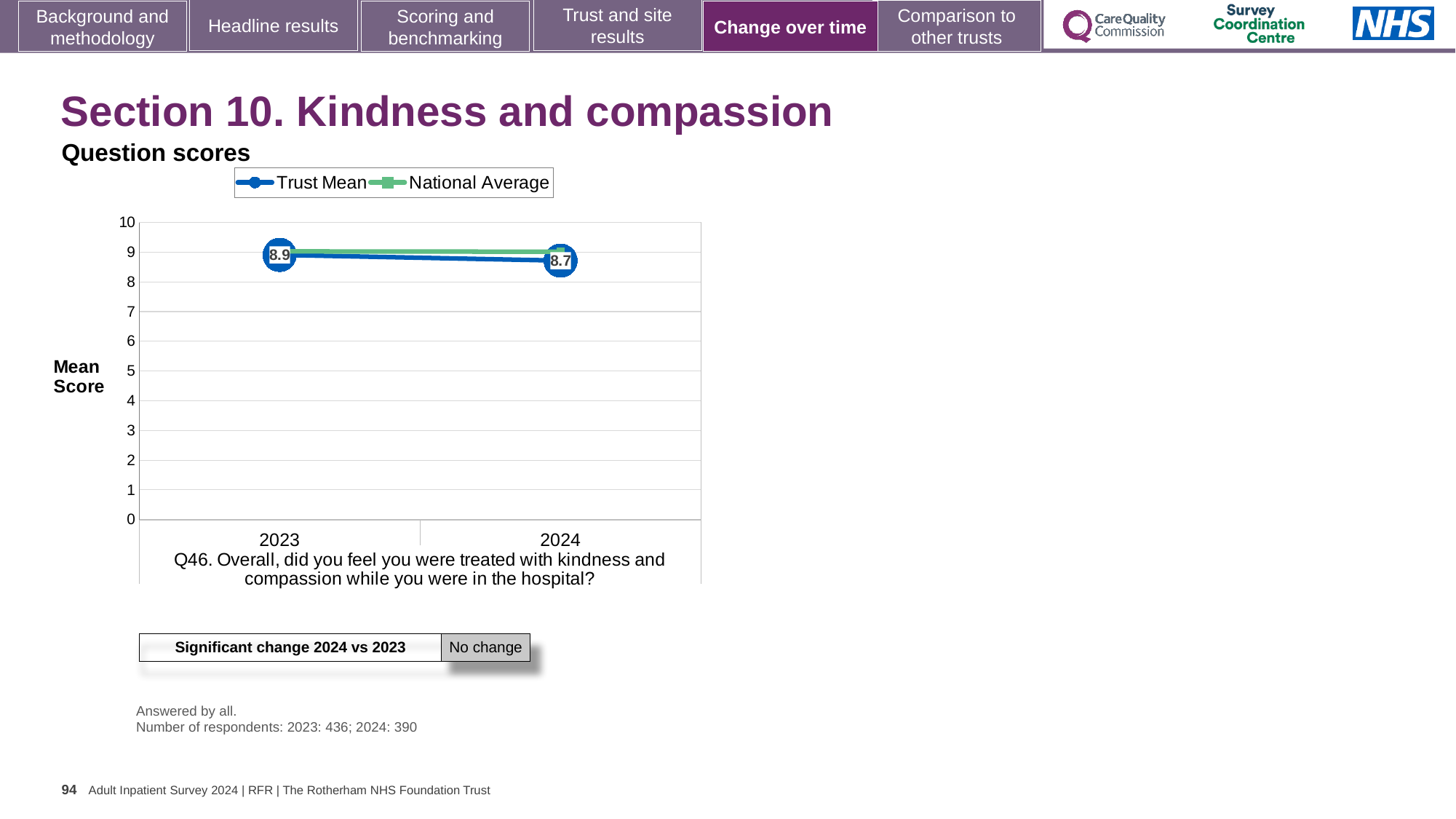
What kind of chart is shown on the slide? line chart What is the Trust Mean score for 2024? 8.7 Is the National Average value for 2024 greater or less than 5? greater How many years are plotted on the x axis of the chart? 2 Is the Trust Mean value for 2023 greater or less than 8? greater What is the Trust Mean score for 2023? 8.9 In 2024, which is higher, the Trust Mean or the National Average? National Average Which year has the higher Trust Mean score, 2023 or 2024? 2023 What is the label on the y axis of the chart? Mean Score How many series does the chart legend list? 2 By how much did the Trust Mean score change from 2023 to 2024? 0.2 Does the Trust Mean score rise or fall from 2023 to 2024? fall